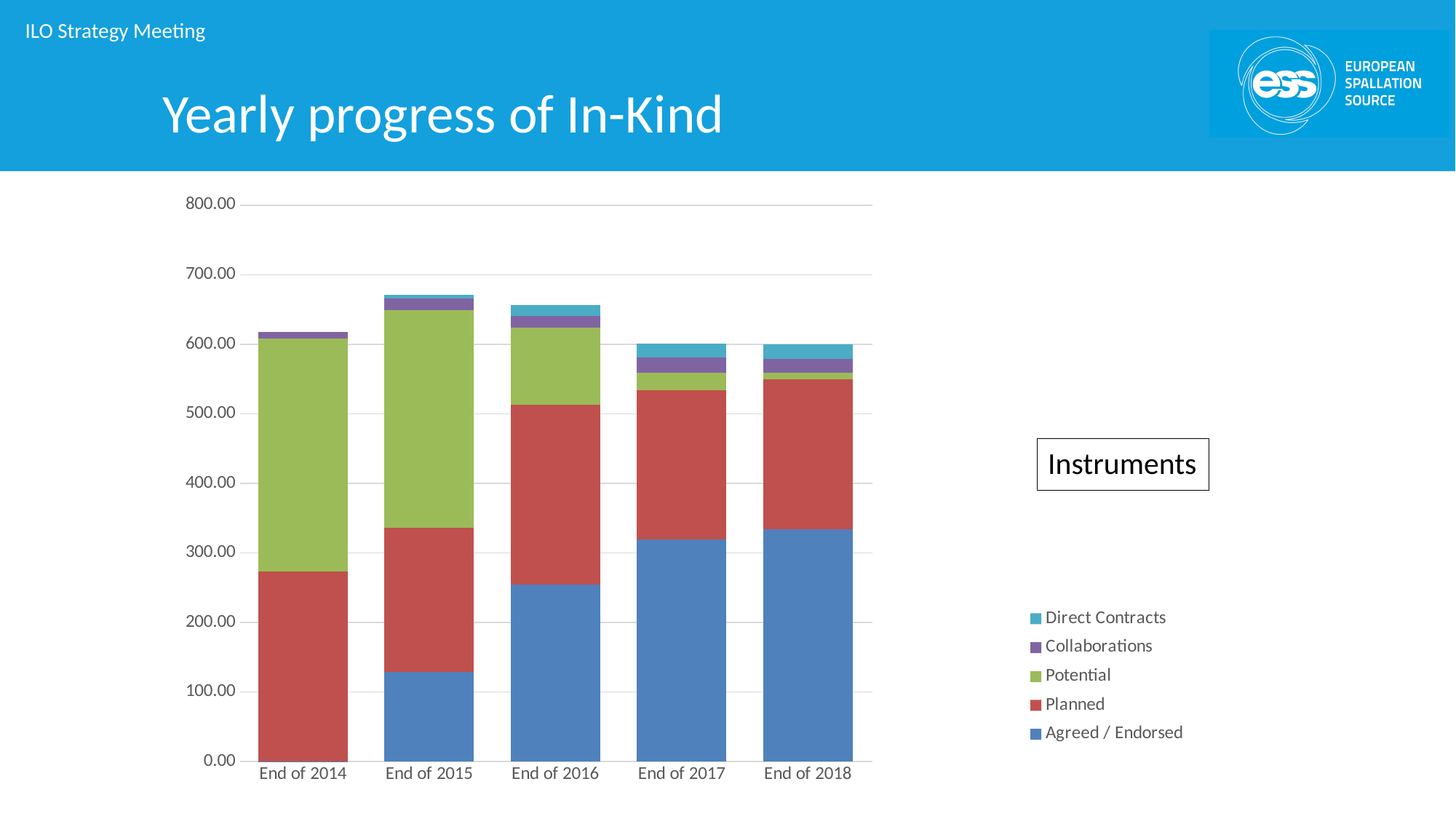
Is the Agreed / Endorsed value for End of 2018 greater or less than 300? greater Does the Agreed / Endorsed segment rise or fall from End of 2014 to End of 2018? rise Which is larger: the Agreed / Endorsed value for End of 2016 or for End of 2015? End of 2016 What is the title of the chart slide? Yearly progress of In-Kind Which year has the tallest stacked bar overall? End of 2015 What kind of chart is shown on the slide? Stacked bar chart How many categories (years) are shown on the x axis? 5 Is the Agreed / Endorsed value for End of 2015 greater or less than 200? less Does the Potential segment get larger or smaller from End of 2015 to End of 2018? smaller Is the total stacked value for End of 2016 greater or less than 600? greater How many series does the legend list? 5